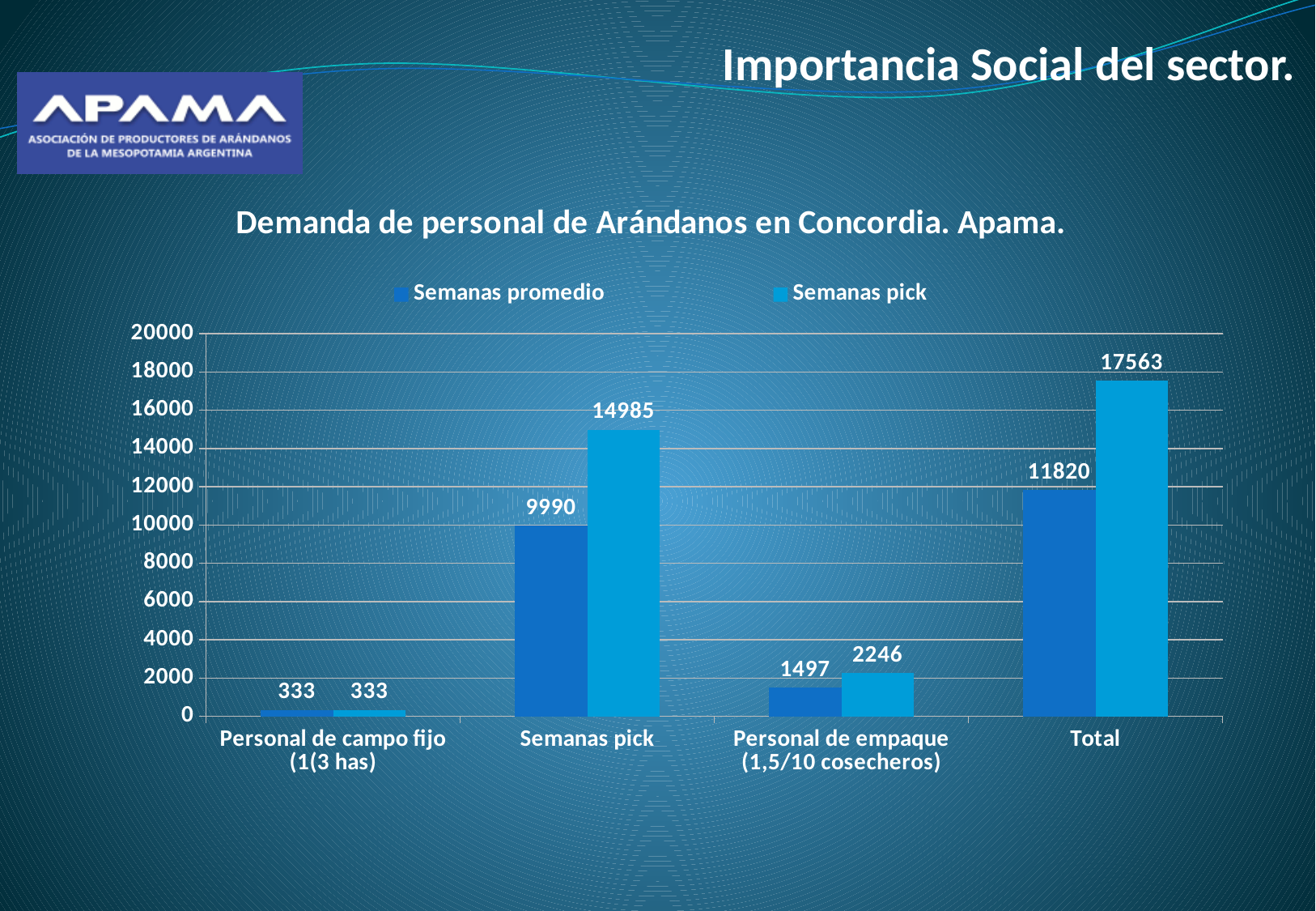
What is the value of Semanas promedio for Personal de empaque (1,5/10 cosecheros)? 1497 Which category has the lowest Semanas promedio value? Personal de campo fijo (1(3 has) Which category has the highest Semanas pick value? Total What is the value of Semanas promedio for Semanas pick? 9990 Which is larger for Personal de empaque (1,5/10 cosecheros): Semanas promedio or Semanas pick? Semanas pick What is the value of Semanas pick for Personal de campo fijo (1(3 has)? 333 How many series does the legend list? 2 What is the difference between Semanas pick and Semanas promedio for the Total category? 5743 How many categories are shown on the x axis? 4 What is the value of Semanas pick for Total? 17563 What type of chart is shown on the slide? Bar chart What is the difference between Semanas pick and Semanas promedio for the Semanas pick category? 4995